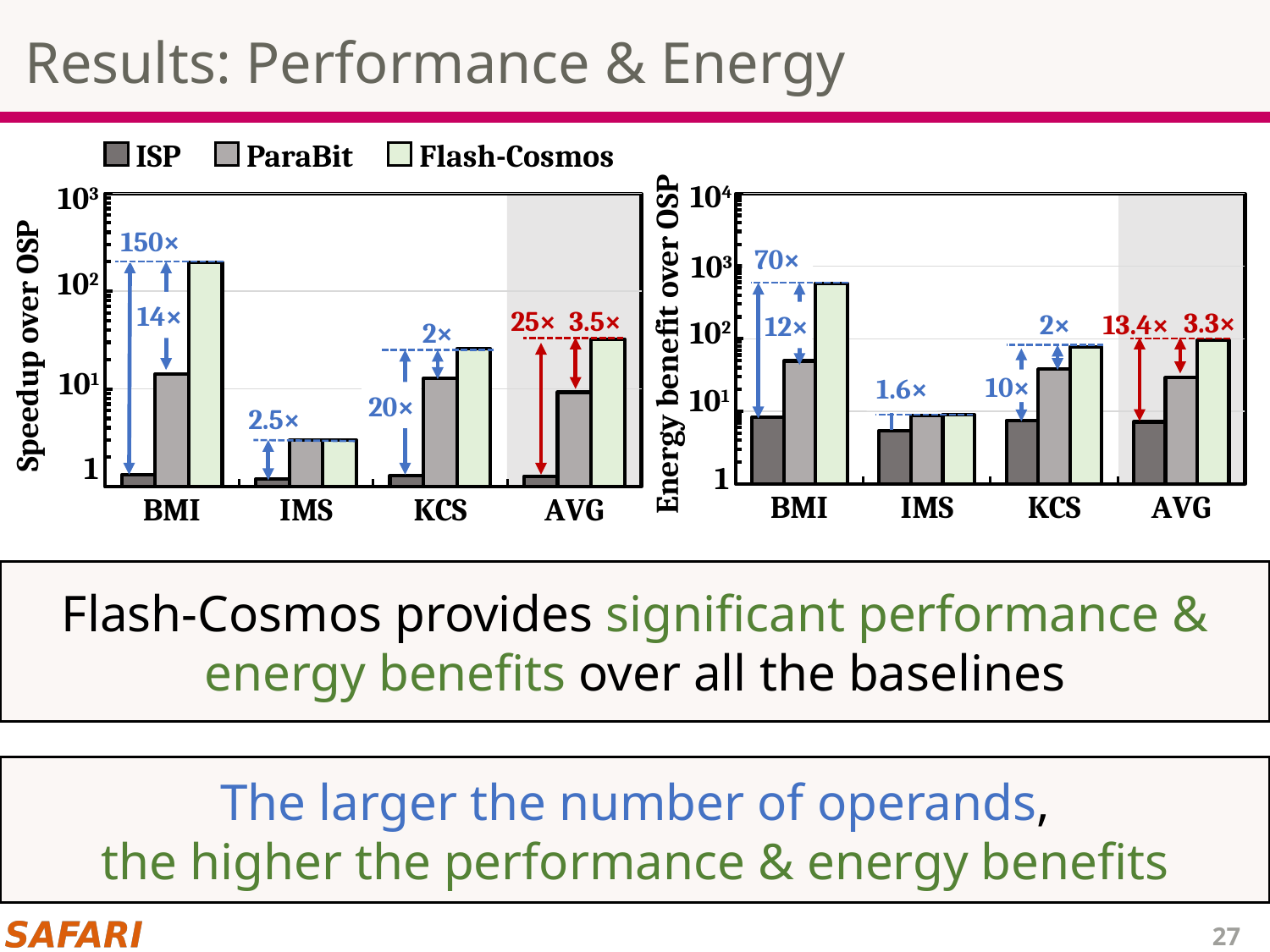
How many series does the legend list for the charts? 3 What kind of chart is the Energy benefit over OSP chart? bar chart In the Speedup over OSP chart, which category has the highest Flash-Cosmos speedup? BMI In the Energy benefit over OSP chart, what energy benefit of Flash-Cosmos over ISP is annotated for AVG? 13.4× In the Speedup over OSP chart, what speedup of Flash-Cosmos over ISP is annotated for BMI? 150× In the Speedup over OSP chart, which category has the lowest Flash-Cosmos speedup? IMS In the Speedup over OSP chart, how many categories are shown on the x axis? 4 In the Energy benefit over OSP chart, which category has the highest Flash-Cosmos energy benefit? BMI In the Speedup over OSP chart, is the Flash-Cosmos speedup for BMI greater or less than 100? greater In the Speedup over OSP chart, what speedup of Flash-Cosmos over ParaBit is annotated for AVG? 3.5× In the Energy benefit over OSP chart, which is larger for KCS: the ParaBit bar or the Flash-Cosmos bar? Flash-Cosmos